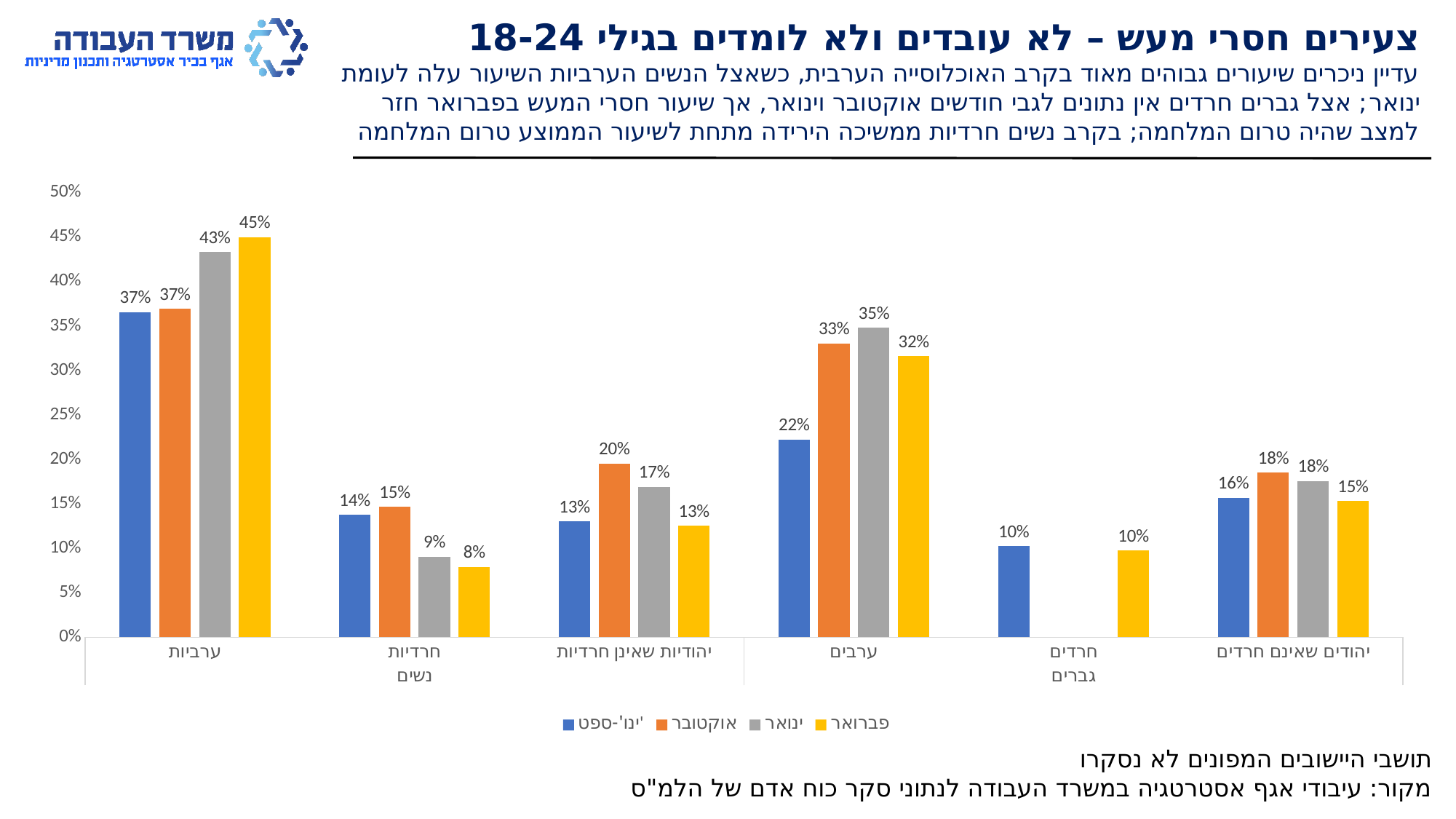
What is the value for ערבים in the ינואר series? 35% Which is larger for יהודים שאינם חרדים: the אוקטובר value or the פברואר value? אוקטובר Which category has the lowest value in the ינואר series? חרדיות Which series is shown in yellow in the legend? פברואר What kind of chart is shown on the slide? Bar chart What is the value for יהודיות שאינן חרדיות in the אוקטובר series? 20% How many series does the legend list? 4 Which category has the highest value in the פברואר series? ערביות What is the value for חרדיות in the פברואר series? 8% How many categories are shown on the x axis? 6 What is the value for ערביות in the פברואר series? 45% What is the difference between the ינואר and יוני-ספט' values for ערבים? 13%